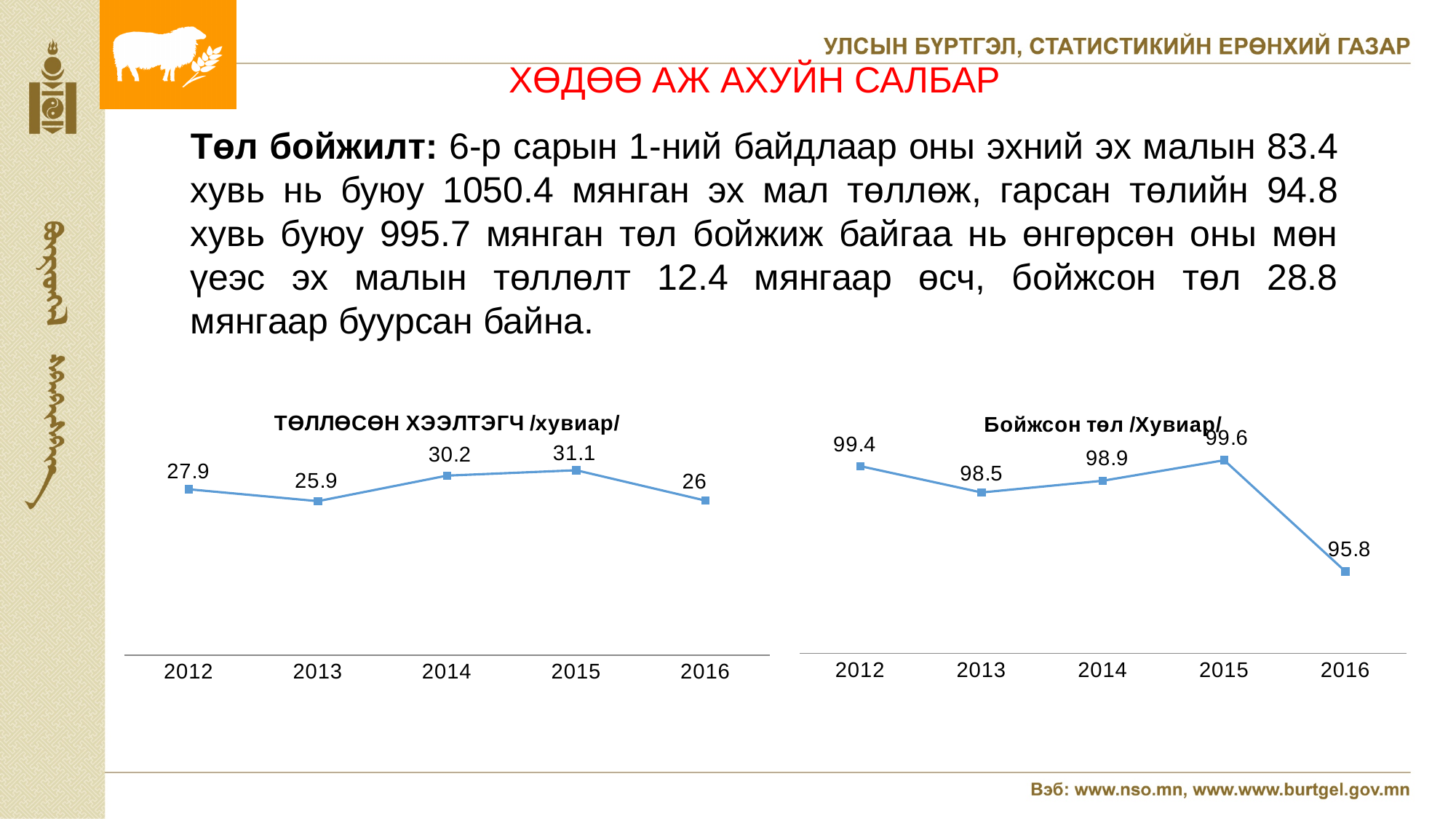
What type of chart is the left chart (ТӨЛЛӨСӨН ХЭЭЛТЭГЧ /хувиар/)? Line chart In the right chart (Бойжсон төл /Хувиар/), which year has the lowest value? 2016 In the left chart (ТӨЛЛӨСӨН ХЭЭЛТЭГЧ /хувиар/), how many years are plotted? 5 In the right chart (Бойжсон төл /Хувиар/), which year has the highest value? 2015 In the right chart (Бойжсон төл /Хувиар/), is the value for 2014 larger or smaller than the value for 2013? Larger In the left chart (ТӨЛЛӨСӨН ХЭЭЛТЭГЧ /хувиар/), which year has the lowest value? 2013 In the left chart (ТӨЛЛӨСӨН ХЭЭЛТЭГЧ /хувиар/), what is the difference between the 2015 and 2016 values? 5.1 In the right chart (Бойжсон төл /Хувиар/), does the value rise or fall from 2015 to 2016? Fall In the right chart (Бойжсон төл /Хувиар/), what is the value for 2016? 95.8 In the left chart (ТӨЛЛӨСӨН ХЭЭЛТЭГЧ /хувиар/), which year has the highest value? 2015 In the left chart (ТӨЛЛӨСӨН ХЭЭЛТЭГЧ /хувиар/), what is the value for 2014? 30.2 In the right chart (Бойжсон төл /Хувиар/), what is the difference between the 2012 and 2013 values? 0.9